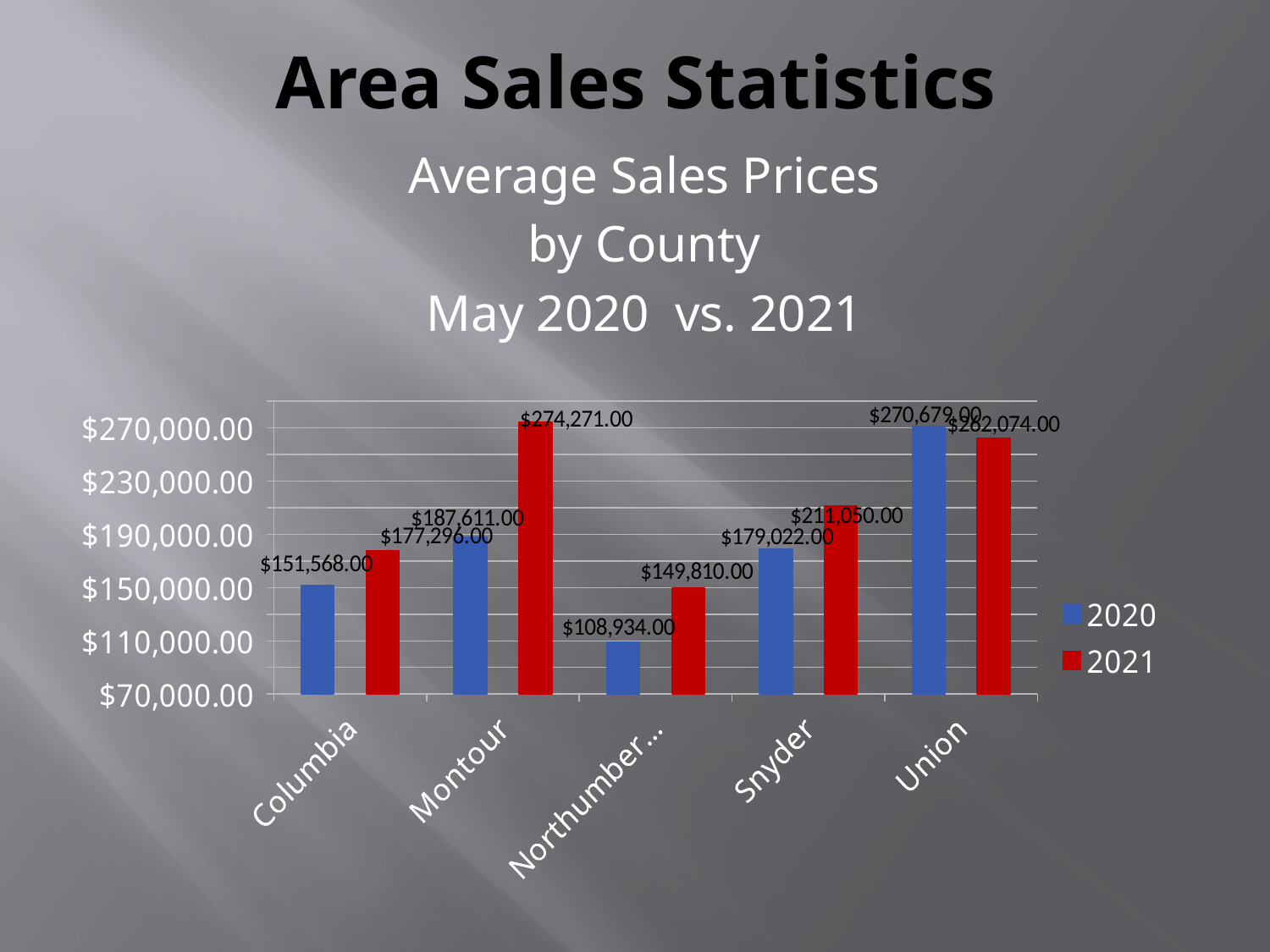
Which county had the highest average sales price in 2020? Union How many series does the legend list? 2 What was the average sales price in Union in 2020? $270,679.00 What was the average sales price in Columbia in 2020? $151,568.00 Is the 2021 value for Union greater or less than $230,000.00? greater Which was larger in 2021: the average sales price in Snyder or in Montour? Montour What was the average sales price in Montour in 2021? $274,271.00 Which county had the highest average sales price in 2021? Montour What was the average sales price in Snyder in 2020? $179,022.00 How many counties are shown on the chart? 5 What is the difference between Montour's 2021 and 2020 average sales prices? $86,660.00 How much higher was Columbia's average sales price in 2021 than in 2020? $25,728.00